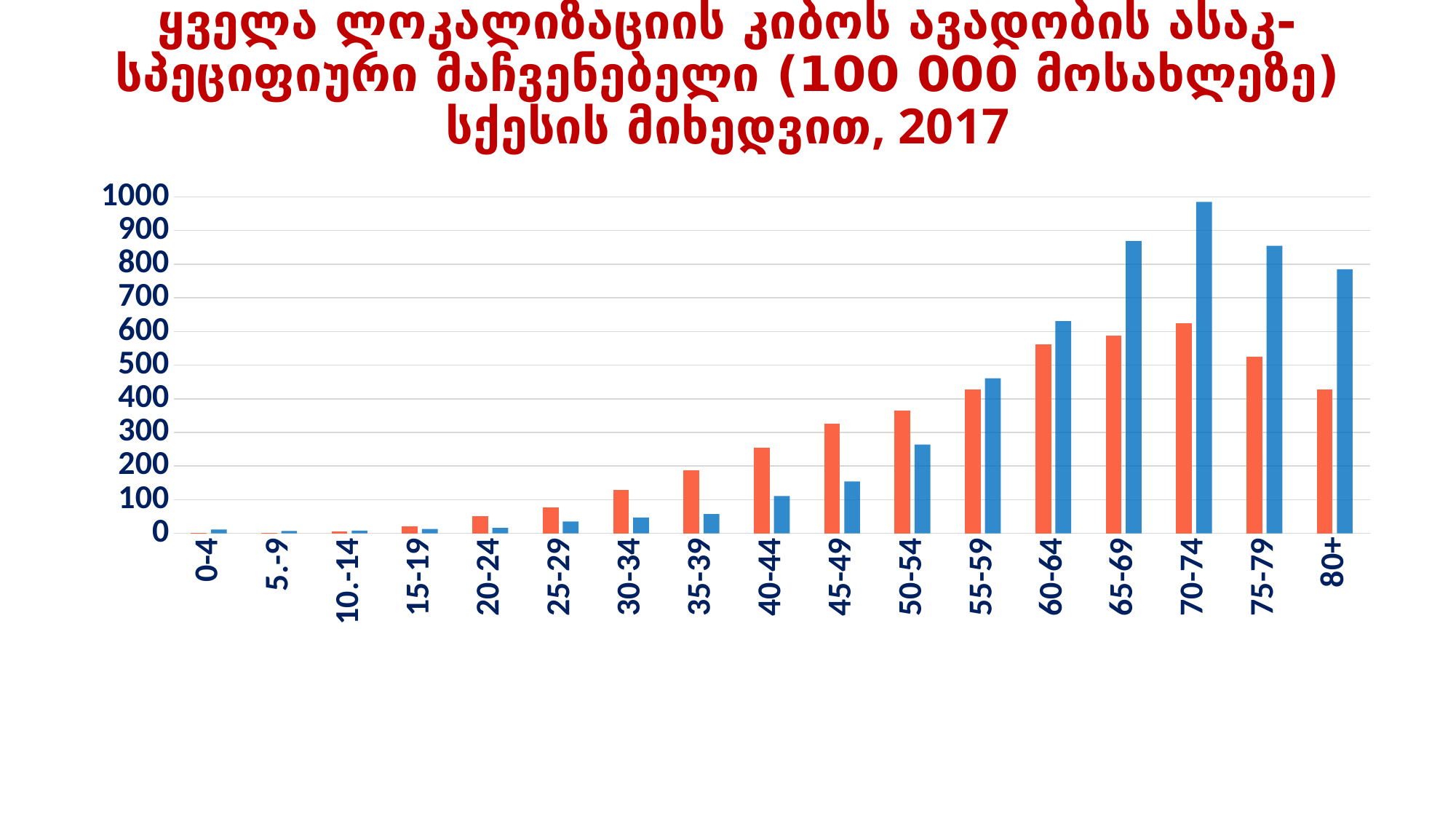
What kind of chart is shown on the slide? bar chart Which year is stated in the chart title? 2017 Is the blue bar for 70-74 greater or less than 900? greater Is the orange bar for 50-54 greater or less than 400? less Is the orange bar for 80+ greater or less than 500? less For the 80+ age group, which bar is taller, the orange or the blue? blue For the 40-44 age group, which bar is taller, the orange or the blue? orange How many age-group categories are shown on the x axis? 17 Do the blue bars rise or fall from the 0-4 group to the 70-74 group? rise Which age group has the highest blue bar? 70-74